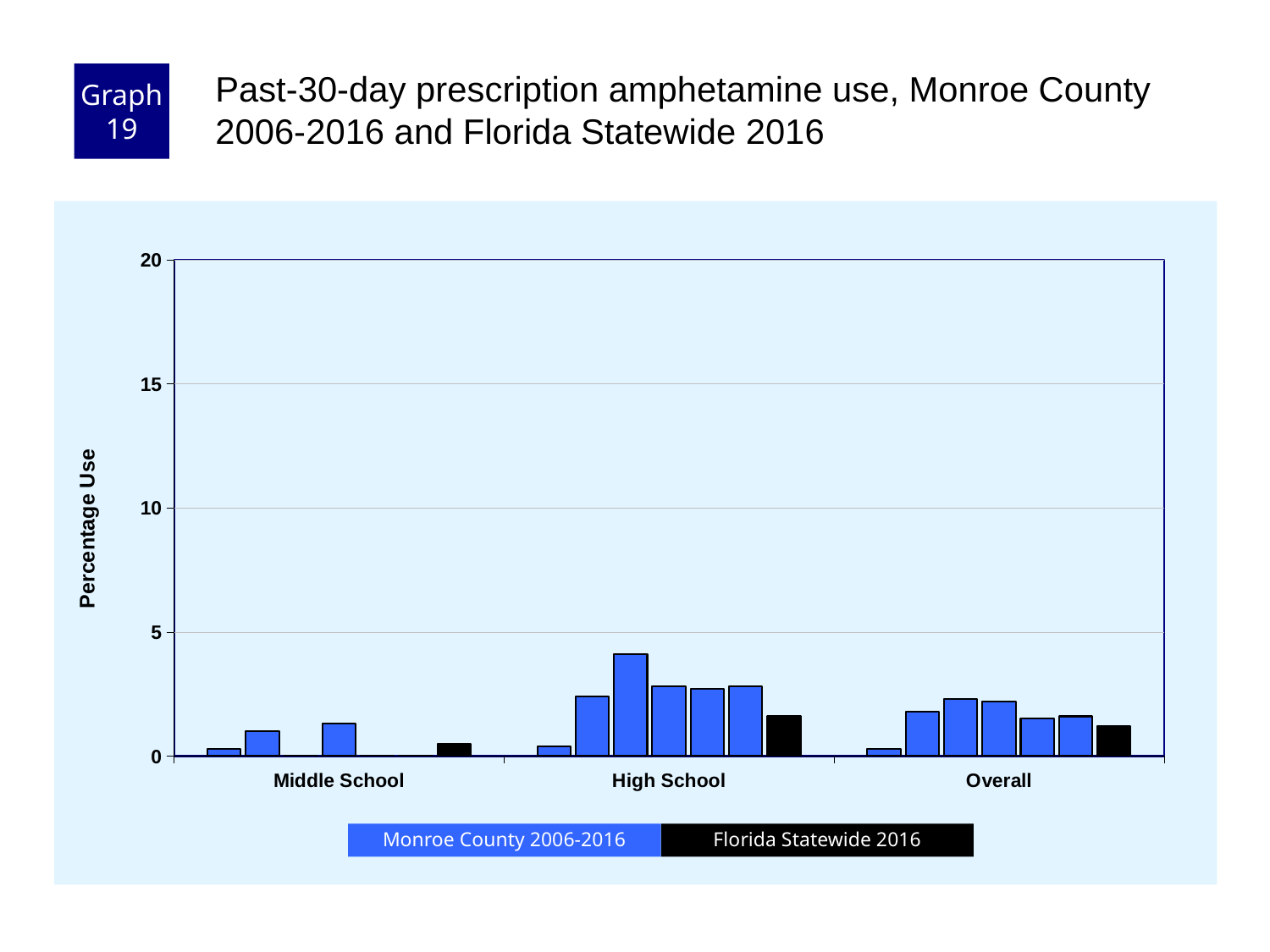
Which is larger, the Florida Statewide 2016 value for High School or for Middle School? High School How many categories are shown on the x axis? 3 Which is larger, the Florida Statewide 2016 value for Overall or for Middle School? Overall Which category has the lowest Florida Statewide 2016 value? Middle School What is the label on the y axis? Percentage Use Is the Florida Statewide 2016 value for Middle School greater or less than 5? less Is the tallest Monroe County 2006-2016 bar in the High School group greater or less than 5? less How many series does the legend list? 2 What colour represents Florida Statewide 2016 in the legend? black Is the Florida Statewide 2016 value for High School greater or less than 5? less Which category has the highest Florida Statewide 2016 value? High School What kind of chart is shown on the slide? bar chart